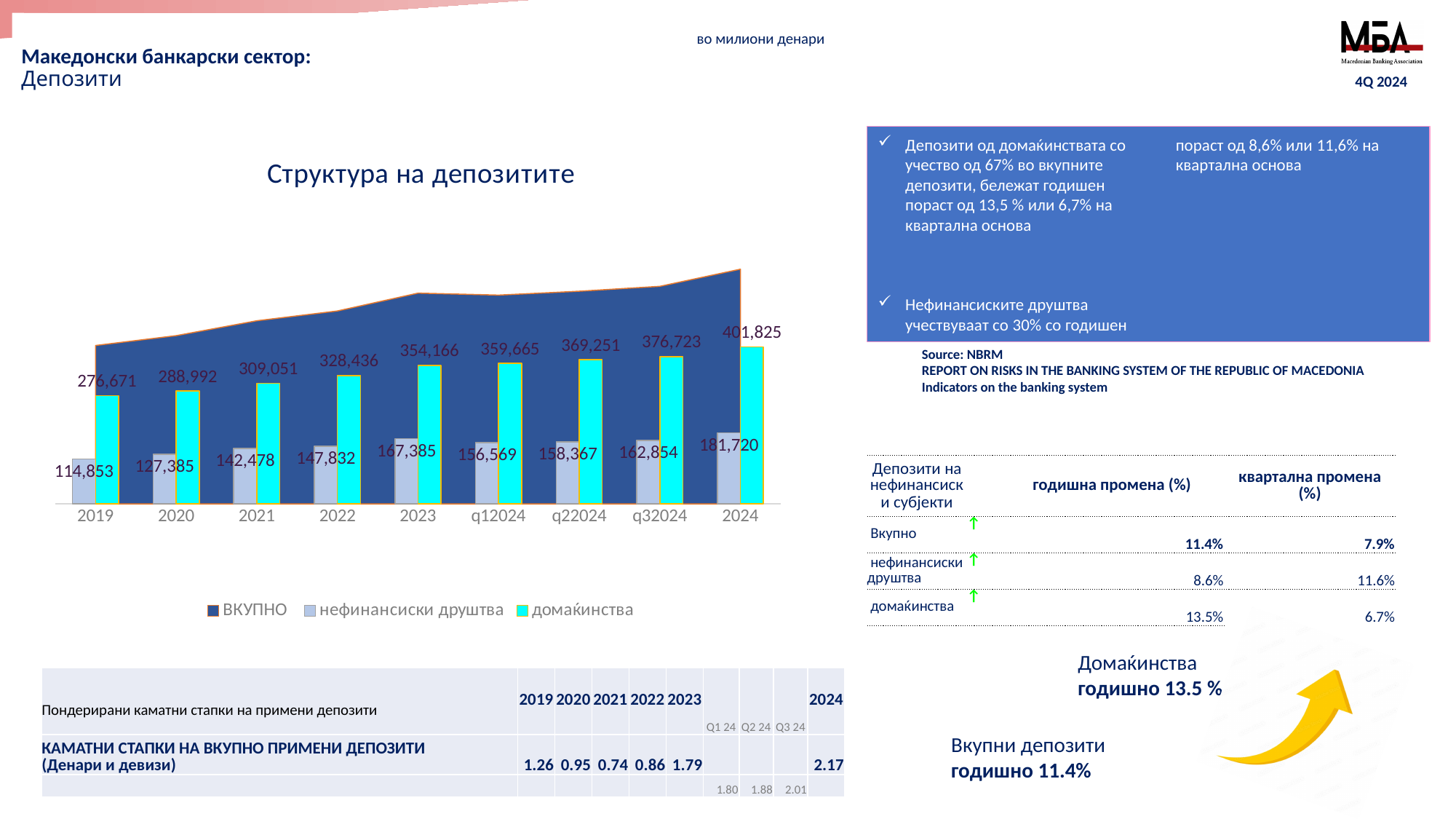
In the chart 'Структура на депозитите', what is the difference between домаќинства and нефинансиски друштва in 2024? 220,105 In the chart 'Структура на депозитите', what is the value for домаќинства in 2024? 401,825 In the chart 'Структура на депозитите', what is the value for домаќинства in q22024? 369,251 How many series does the legend of the chart 'Структура на депозитите' list? 3 In the chart 'Структура на депозитите', by how much did домаќинства increase from 2019 to 2024? 125,154 In the chart 'Структура на депозитите', which period has the highest value for нефинансиски друштва? 2024 In the chart 'Структура на депозитите', do the values for домаќинства rise or fall from 2019 to 2024? rise How many periods are shown on the x axis of the chart 'Структура на депозитите'? 9 In the chart 'Структура на депозитите', what is the value for нефинансиски друштва in 2023? 167,385 In the chart 'Структура на депозитите', which is larger for нефинансиски друштва: 2023 or q12024? 2023 In the chart 'Структура на депозитите', what is the value for нефинансиски друштва in 2019? 114,853 In the chart 'Структура на депозитите', which period has the lowest value for домаќинства? 2019